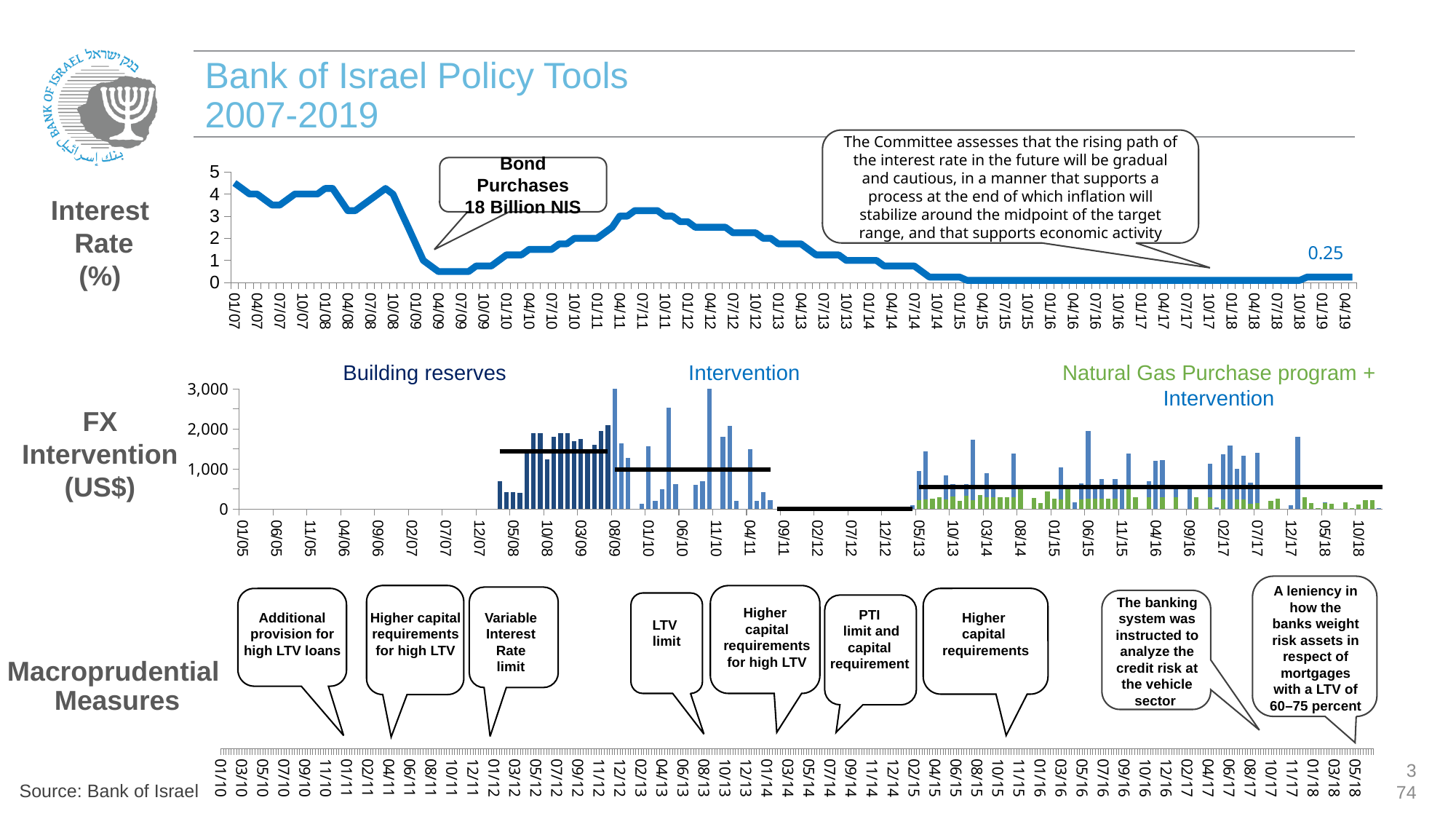
On the FX Intervention (US$) chart, is the bar at 08/09 greater or less than 2,000? greater On the Interest Rate (%) chart, is the value at 01/07 greater or less than 4? greater On the Interest Rate (%) chart, is the value at 07/11 greater or less than 2? greater On the Interest Rate (%) chart, does the interest rate overall rise or fall from 01/07 to 04/19? fall On the FX Intervention (US$) chart, what is the highest value shown on the y axis? 3,000 On the Interest Rate (%) chart, what value is printed as the data label at the end of the line in 2019? 0.25 On the Interest Rate (%) chart, what amount of bond purchases does the callout box state? 18 Billion NIS What kind of chart is the FX Intervention (US$) chart? bar chart On the FX Intervention (US$) chart, which bar is taller, 08/09 or 01/10? 08/09 What kind of chart is the Interest Rate (%) chart? line chart